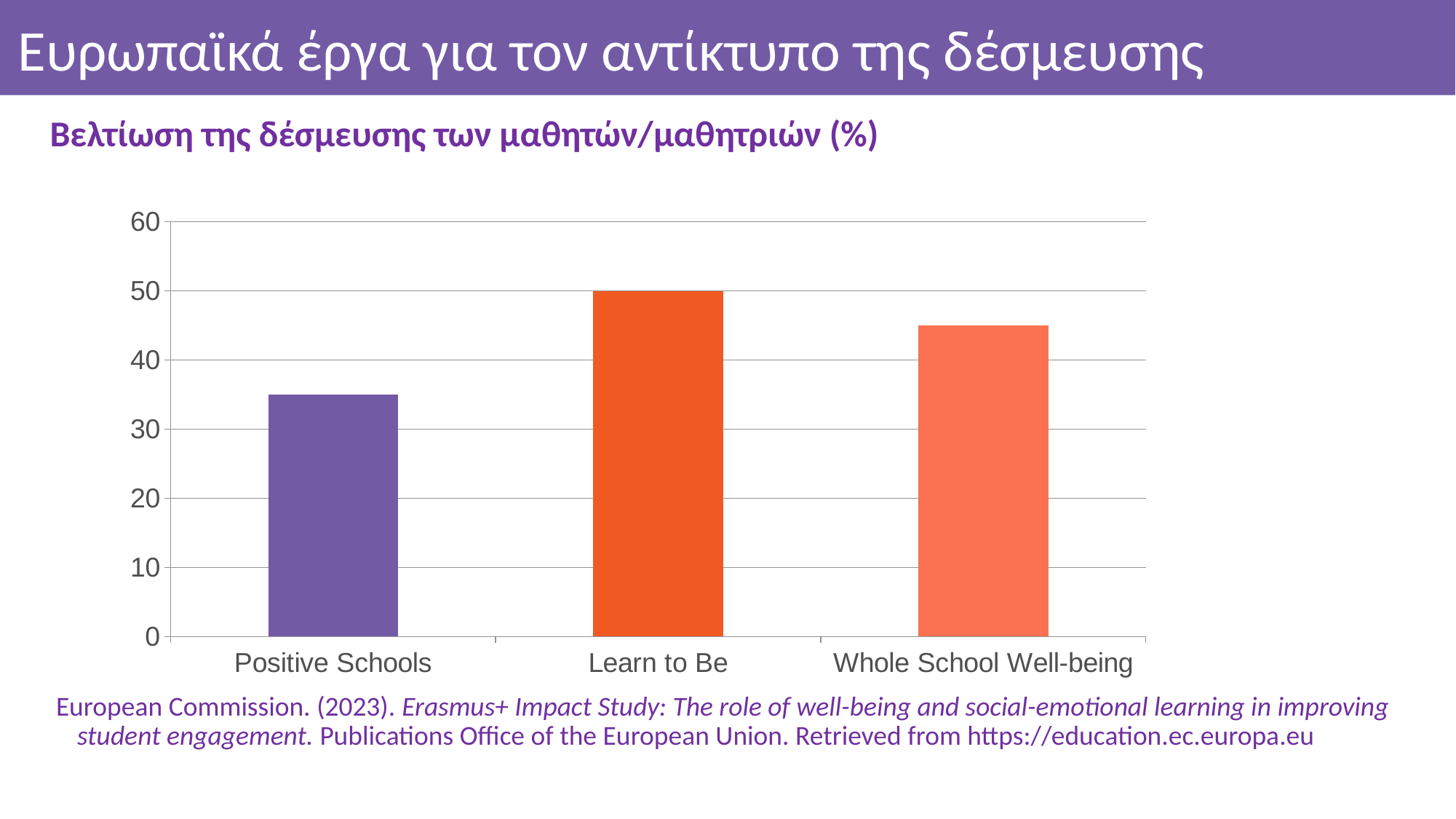
What colour is the bar for Positive Schools? purple What kind of chart is shown on the slide? bar chart How many categories are shown on the x axis of the chart? 3 Which category has the lowest value in the chart? Positive Schools Is the value for Positive Schools greater or less than 40? less Is the value for Positive Schools greater or less than 30? greater What is the value for Learn to Be? 50 Which is larger, the value for Positive Schools or the value for Whole School Well-being? Whole School Well-being Which category has the highest value in the chart? Learn to Be What is the title of the chart? Βελτίωση της δέσμευσης των μαθητών/μαθητριών (%) Which is larger, the value for Learn to Be or the value for Whole School Well-being? Learn to Be Is the value for Whole School Well-being greater or less than 40? greater